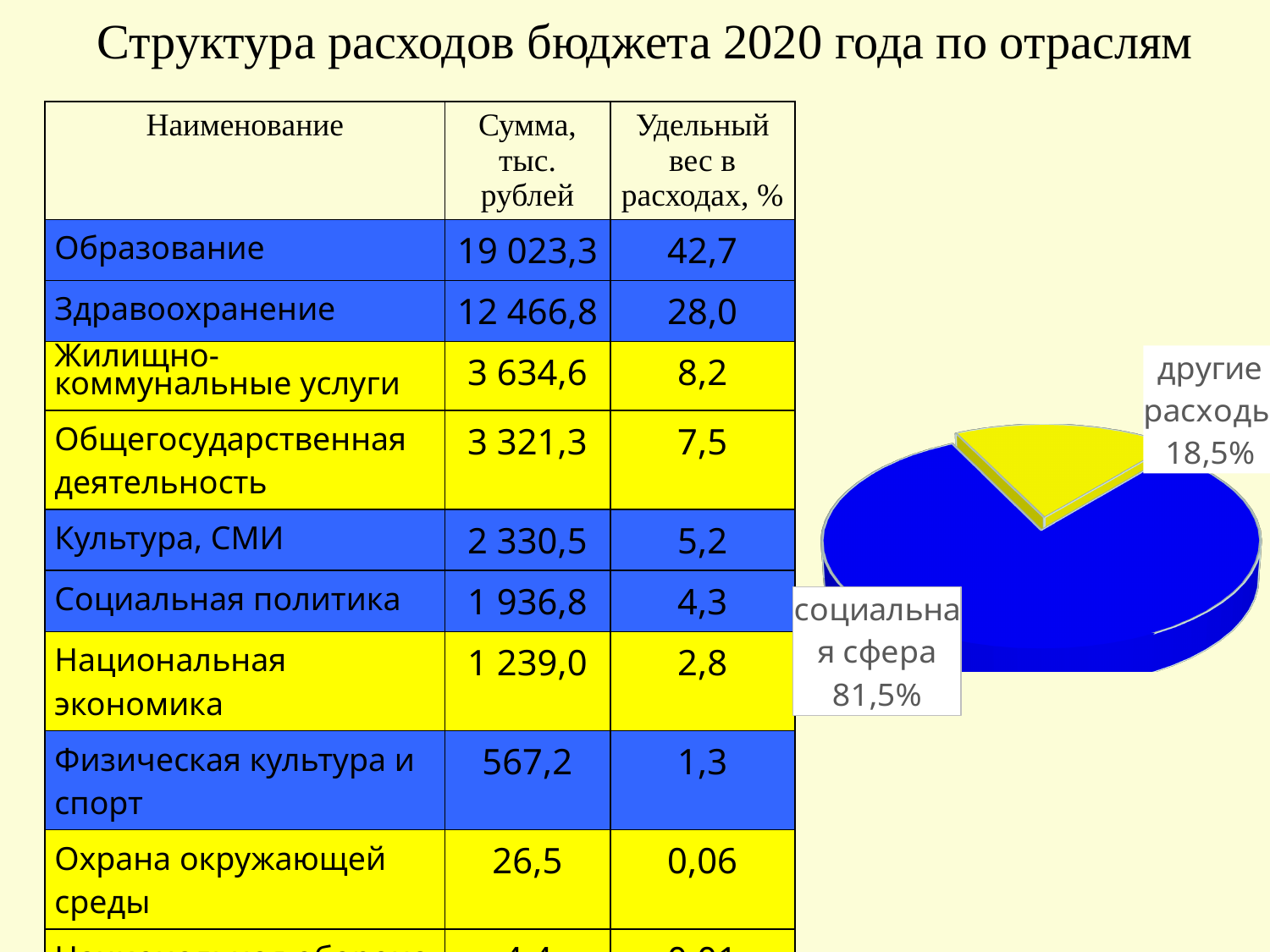
Which slice of the pie chart is the largest? социальная сфера By how many percentage points does "социальная сфера" exceed "другие расходы" in the pie chart? 63,0% What is the value shown for "другие расходы" in the pie chart? 18,5% In the pie chart, which is larger: "социальная сфера" or "другие расходы"? социальная сфера Which slice of the pie chart is the smallest? другие расходы What kind of chart is shown on the right side of the slide? pie chart How many slices does the pie chart have? 2 What share of the pie chart does "социальная сфера" take? 81,5% What colour is the "другие расходы" slice in the pie chart? yellow What colour is the "социальная сфера" slice in the pie chart? blue What do the two slices of the pie chart add up to? 100%